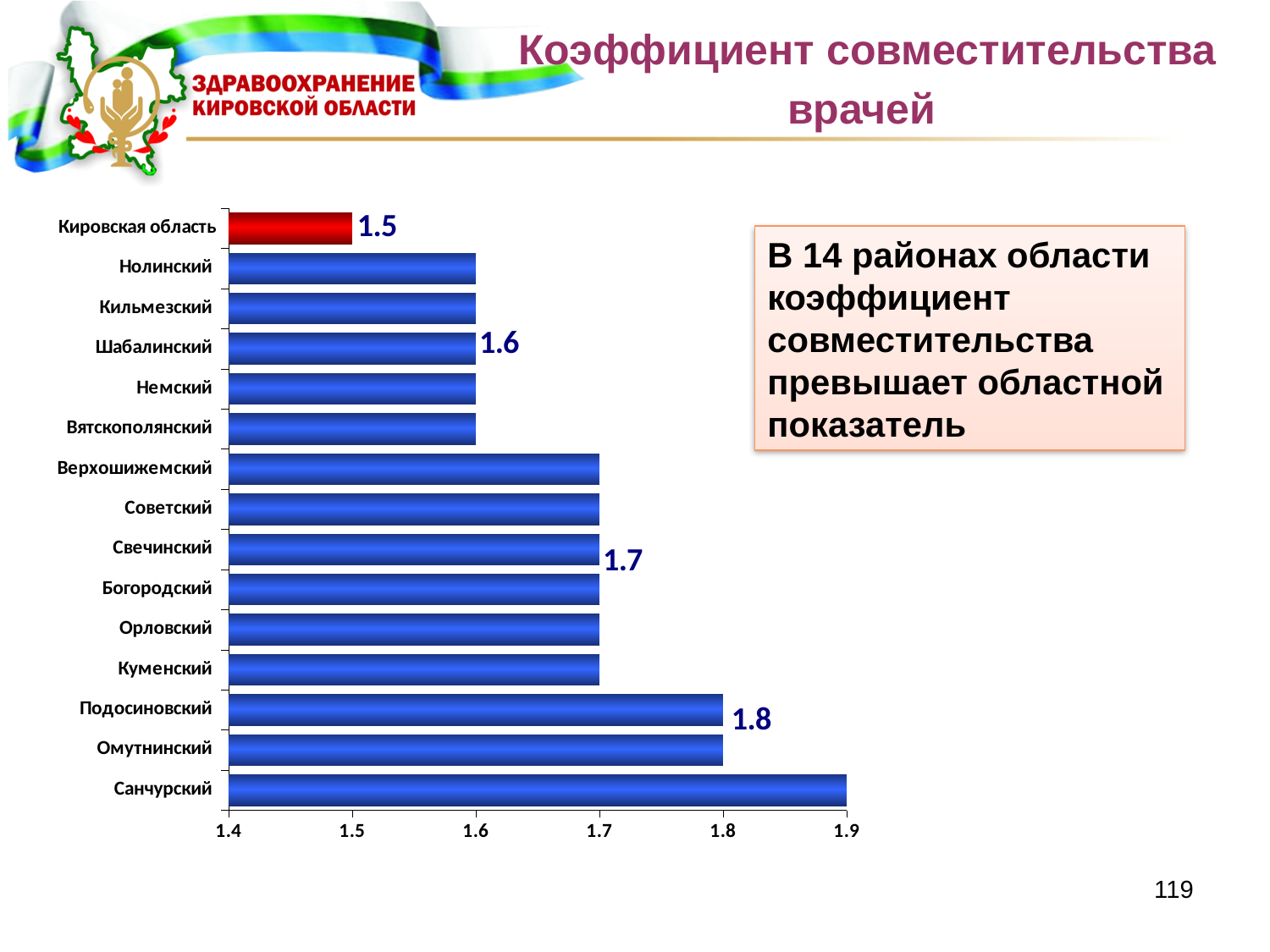
What is the value for Подосиновский? 1.8 Which bar is coloured red rather than blue? Кировская область How many categories are shown on the chart? 15 Which category has the highest value? Санчурский What type of chart is shown on the slide? bar chart Which category has the lowest value? Кировская область What is the value for Шабалинский? 1.6 Is the value for Санчурский greater or less than 1.8? greater What is the difference between the values for Подосиновский and Кировская область? 0.3 Which is larger, the value for Советский or the value for Немский? Советский What is the value for Кировская область? 1.5 What is the value for Свечинский? 1.7